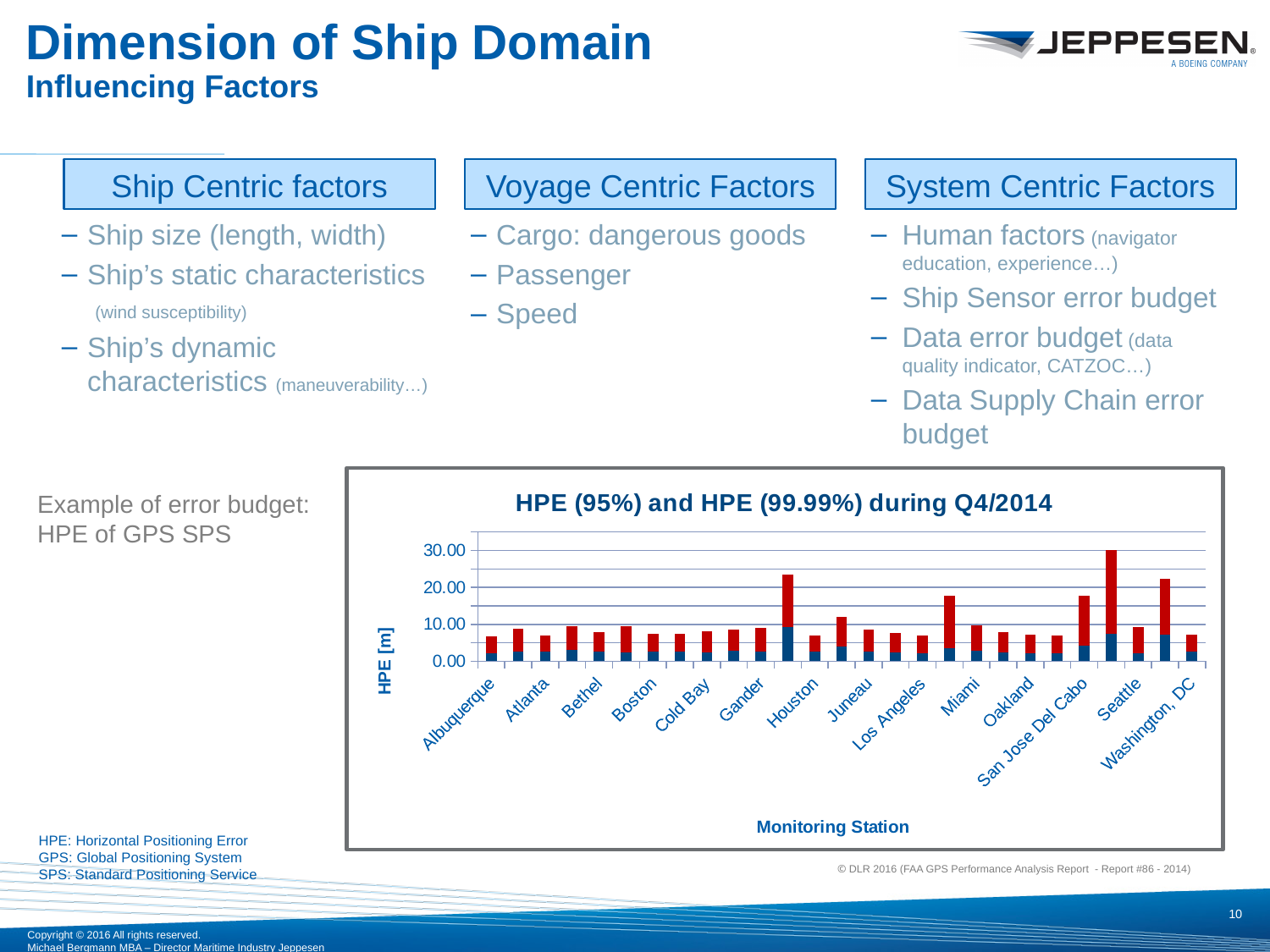
What is the label of the vertical axis of the chart? HPE [m] Is the total value for Albuquerque greater or less than 10.00? less Is the total value for Washington, DC greater or less than 10.00? less What is the title of the chart? HPE (95%) and HPE (99.99%) during Q4/2014 Is the total value for Los Angeles greater or less than 10.00? less Which has the larger total HPE bar, Seattle or Houston? Seattle Which has the larger total HPE bar, Atlanta or Seattle? Seattle What kind of chart is shown on the slide? bar chart